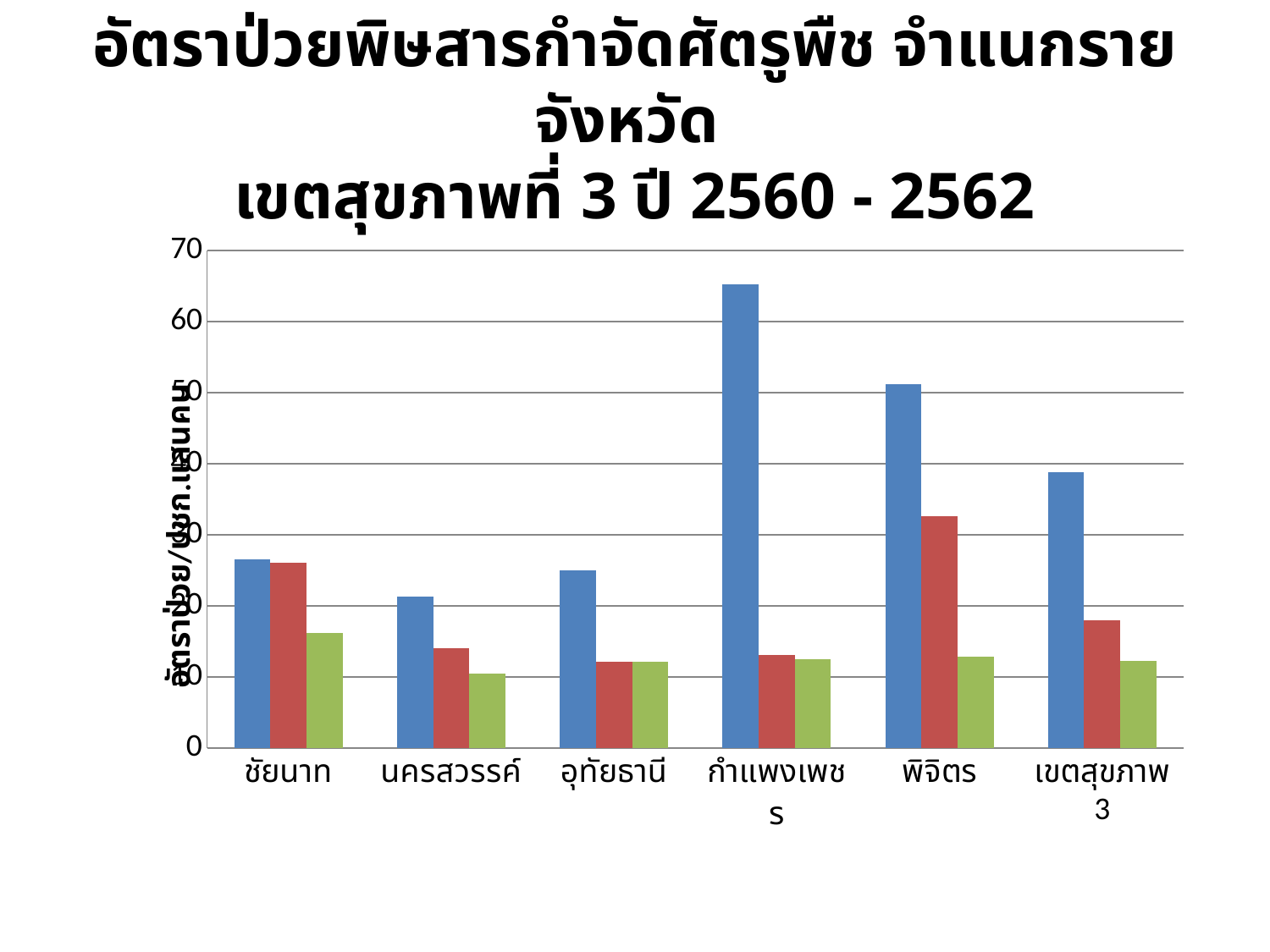
Is the red bar for พิจิตร greater or less than 30? greater Is the green bar for นครสวรรค์ greater or less than 20? less Is the blue bar for เขตสุขภาพ 3 greater or less than 40? less How many categories are shown on the x axis of the chart? 6 What is the highest value shown on the y axis of the chart? 70 Which category has the tallest red bar? พิจิตร Which category has the shortest blue bar? นครสวรรค์ What kind of chart is shown on the slide? bar chart Which is larger, the blue bar for พิจิตร or the blue bar for เขตสุขภาพ 3? พิจิตร Which category has the tallest blue bar? กำแพงเพชร